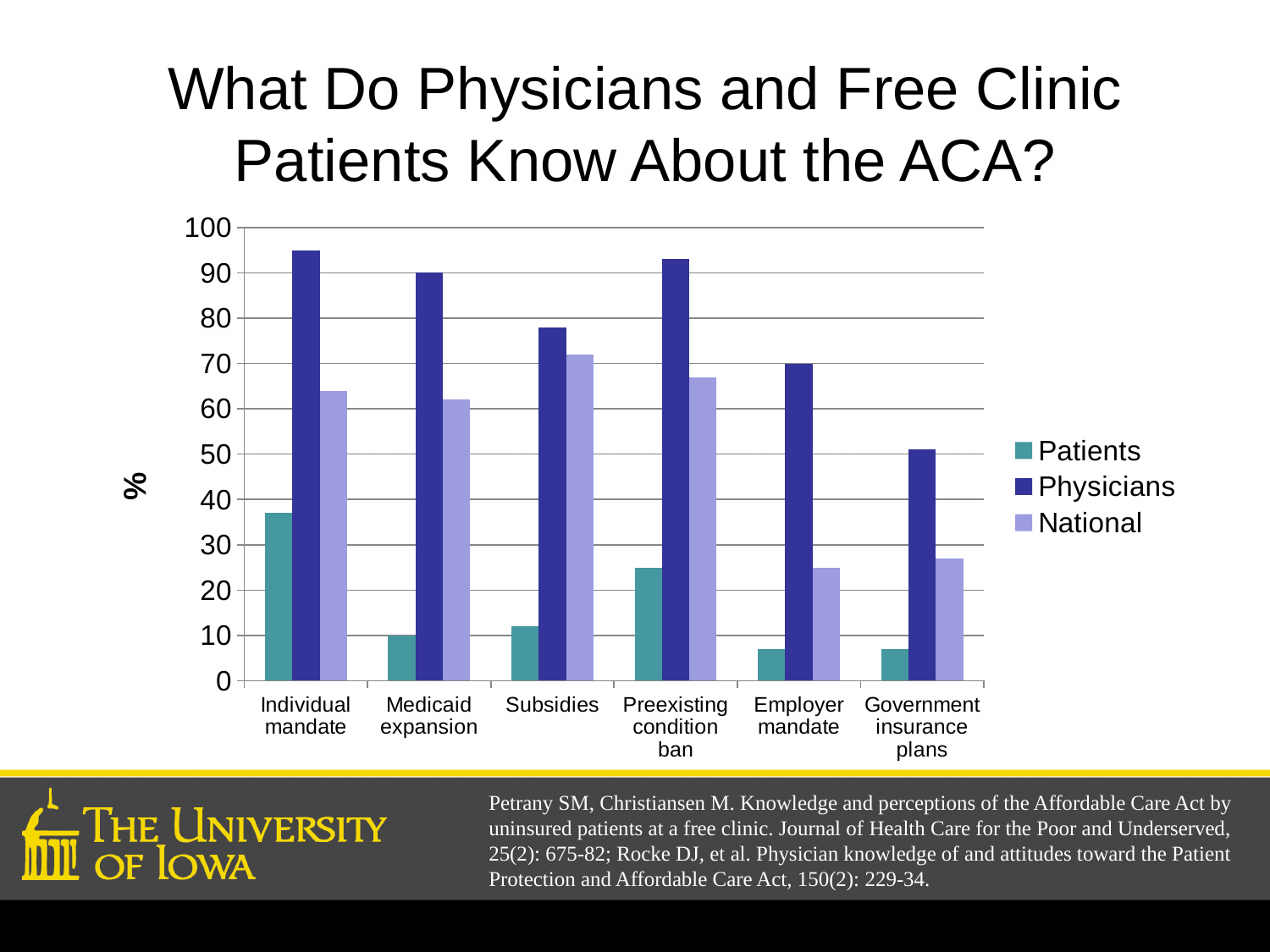
How many series does the legend list? 3 What kind of chart is shown on the slide? bar chart For the Physicians series, which category has the lowest value? Government insurance plans For Individual mandate, which is larger: the Patients value or the National value? National Is the Physicians value for Government insurance plans greater or less than 60? less What is the Physicians value for Medicaid expansion? 90 What is the label on the y axis? % Is the National value for Government insurance plans greater or less than 30? less For Employer mandate, which is larger: the National value or the Patients value? National How many categories are shown along the x axis? 6 Is the Patients value for Individual mandate greater or less than 40? less For the Patients series, which category has the highest value? Individual mandate